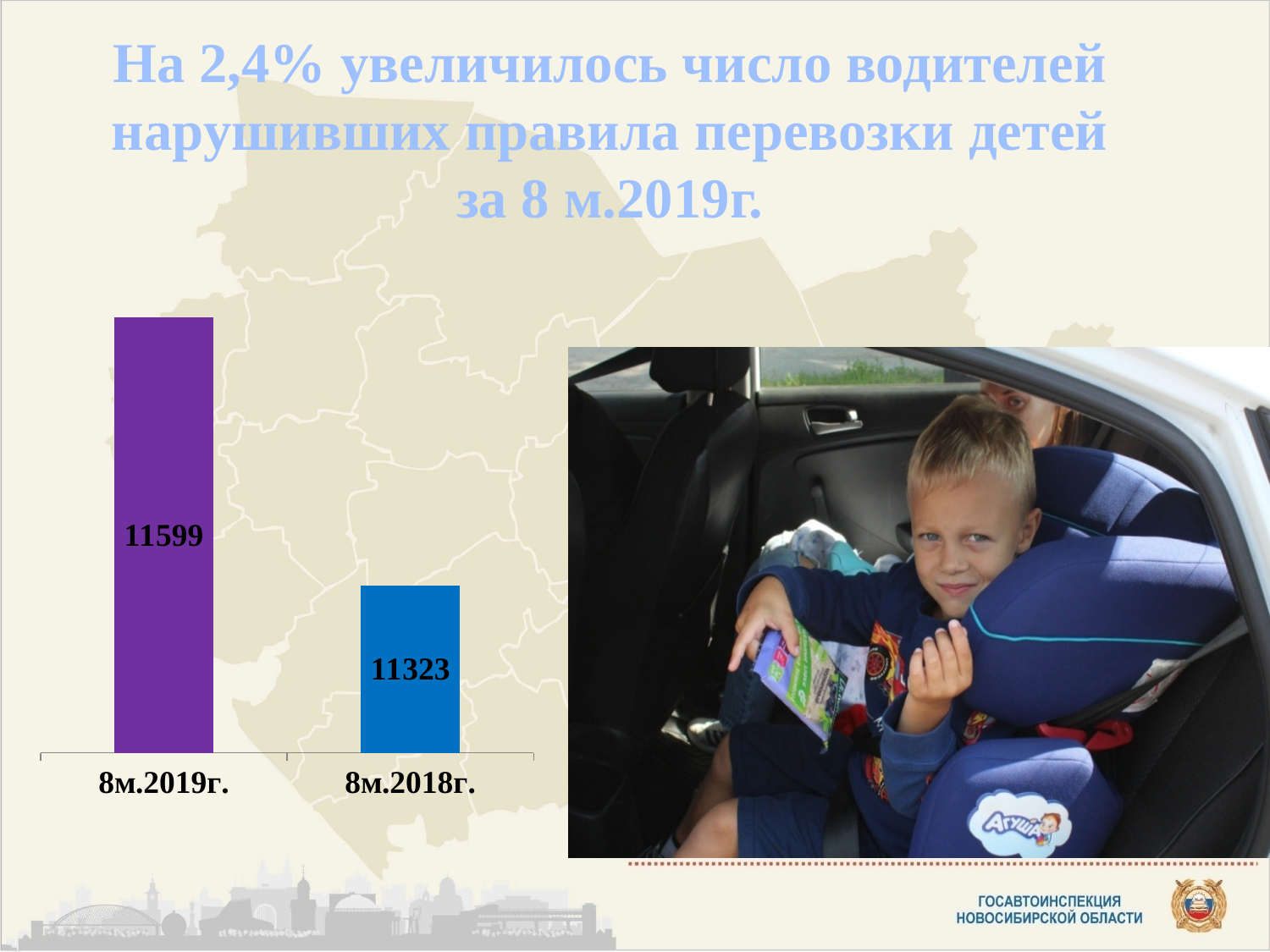
What kind of chart is shown on the slide? bar chart What is the value for 8м.2019г.? 11599 What is the difference between the values for 8м.2019г. and 8м.2018г.? 276 Which category has the highest value? 8м.2019г. How many categories are shown in the chart? 2 What is the value for 8м.2018г.? 11323 Which is larger, the value for 8м.2019г. or 8м.2018г.? 8м.2019г. Which category has the lowest value? 8м.2018г. What colour is the bar for 8м.2019г.? purple Do the values rise or fall from 8м.2019г. to 8м.2018г. along the x axis? fall What colour is the bar for 8м.2018г.? blue